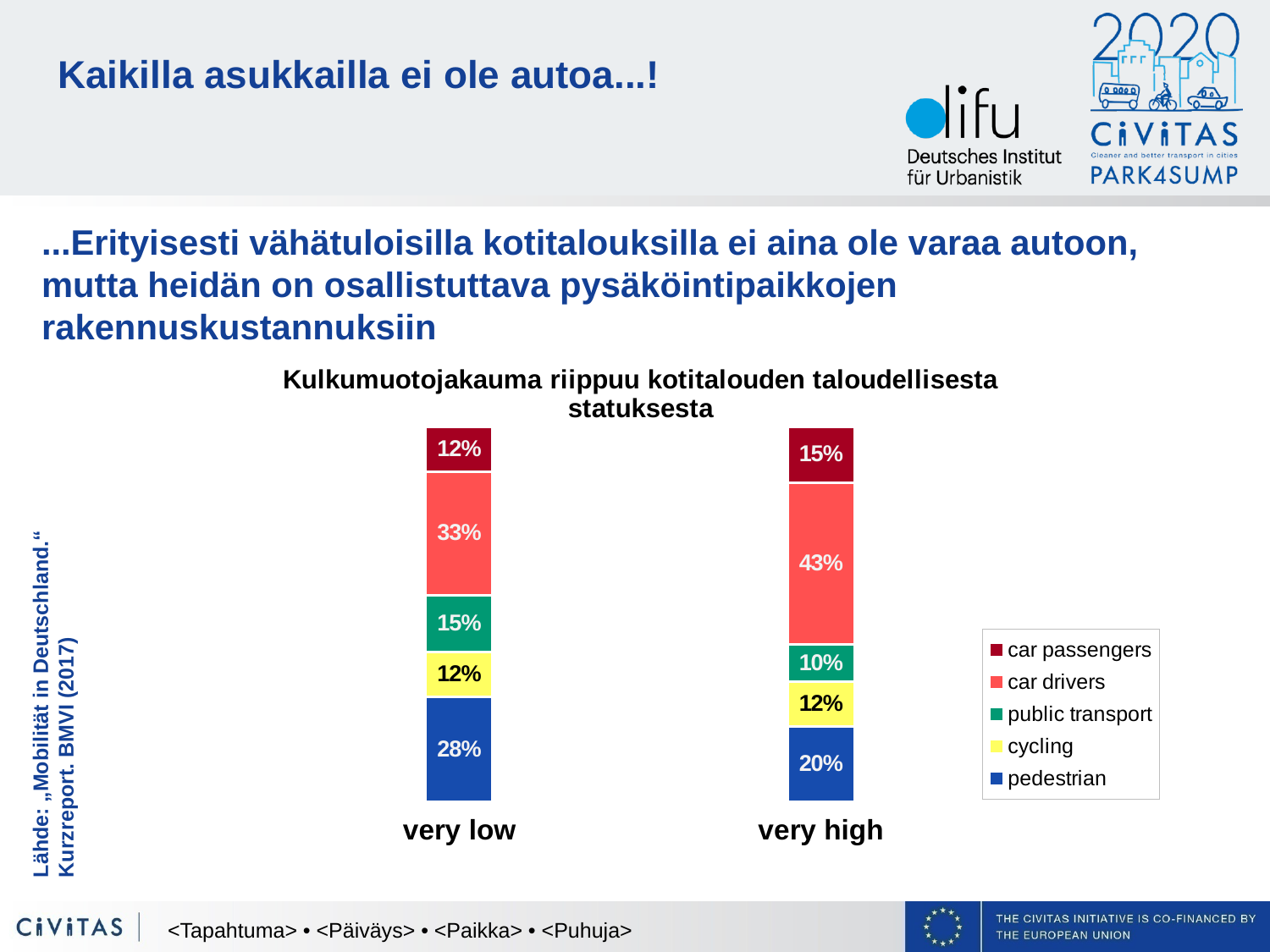
What is the total of the 'very low' stacked bar? 100% Which series has the smallest share in the 'very high' bar? public transport Which category has the larger pedestrian share, 'very low' or 'very high'? very low What is the difference between the car drivers share for 'very high' and for 'very low'? 10% How many categories are shown on the x axis? 2 What kind of chart is shown on the slide? stacked bar chart What is the share of public transport for the 'very high' category? 10% What is the share of car drivers for the 'very low' category? 33% What is the share of car passengers for the 'very low' category? 12% How many series does the legend list? 5 Which series has the largest share in the 'very high' bar? car drivers What is the share of pedestrian for the 'very high' category? 20%